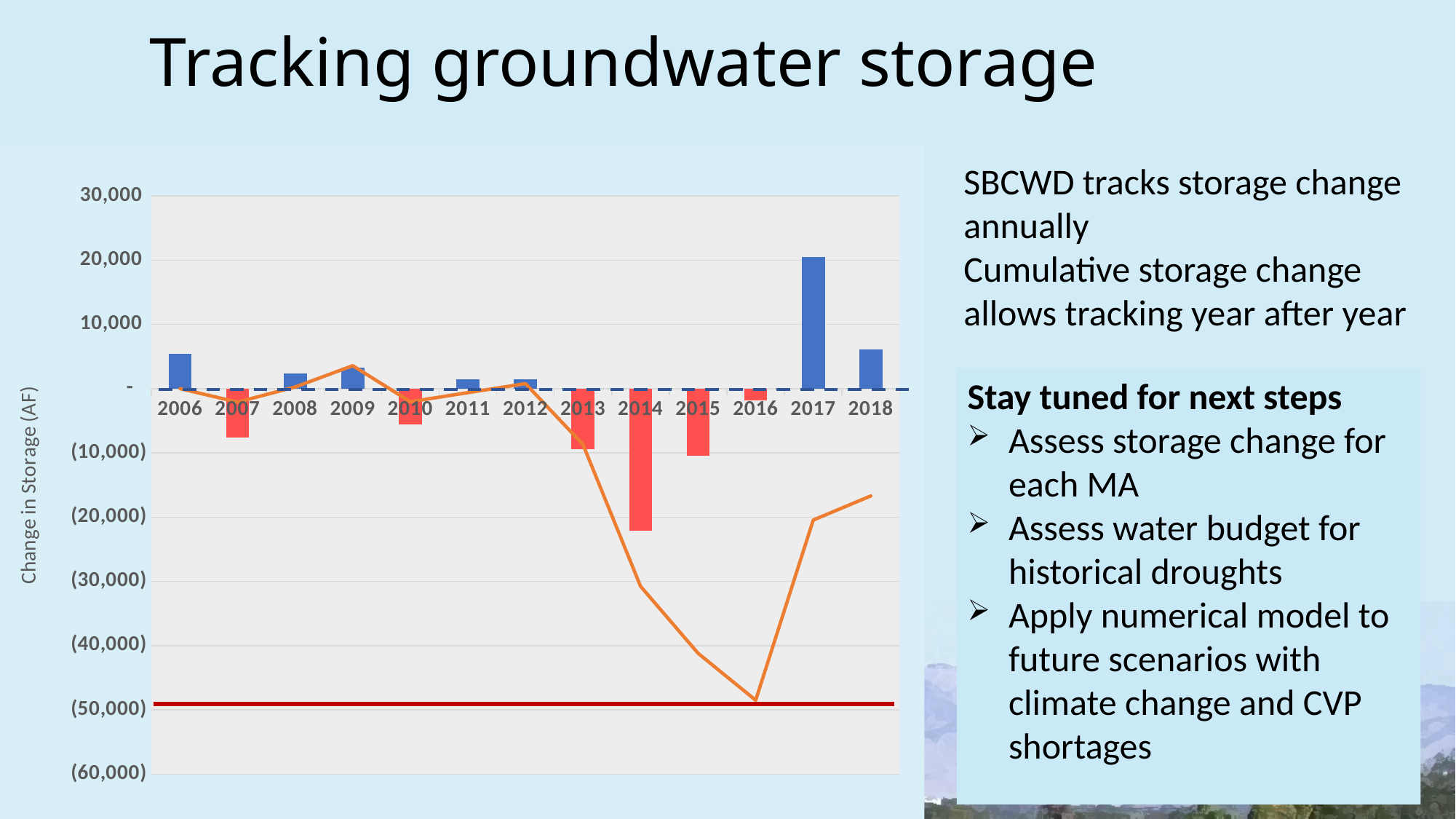
Is the bar value for 2014 greater or less than (10,000)? less Does the orange line rise or fall from 2013 to 2016? fall What is the label on the vertical axis of the chart? Change in Storage (AF) What kind of chart is shown on the slide? Bar chart with a line Which year has the lower bar, 2007 or 2010? 2007 Which year has the highest bar in the chart? 2017 How many years are shown on the x axis of the chart? 13 Is the bar value for 2006 greater or less than 0? greater Is the bar value for 2017 greater or less than 10,000? greater Which year has the lowest bar in the chart? 2014 Which year has the larger bar, 2017 or 2018? 2017 In which year does the orange line reach its lowest point? 2016